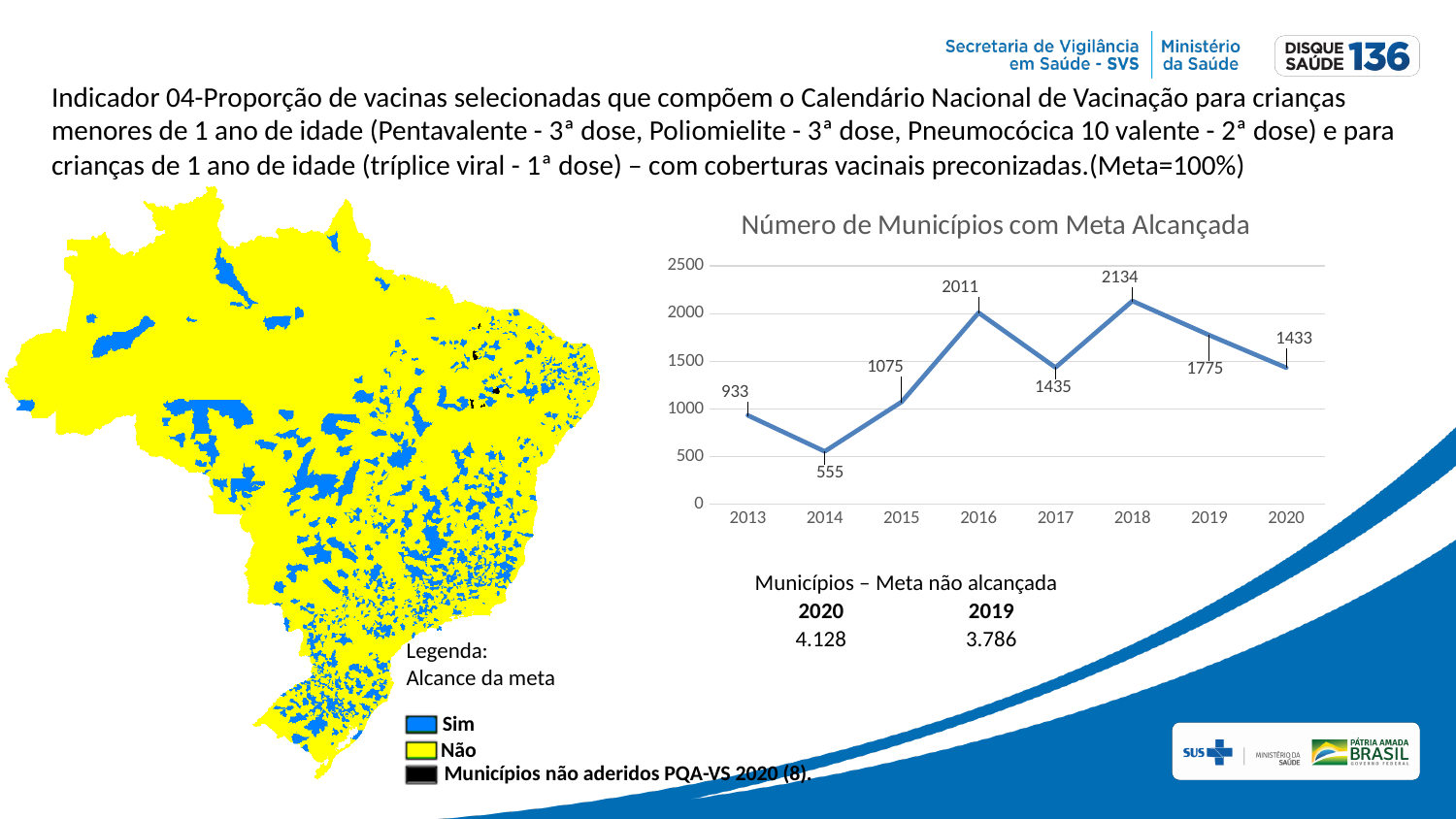
In the chart "Número de Municípios com Meta Alcançada", what is the difference between the values for 2016 and 2017? 576 In the chart "Número de Municípios com Meta Alcançada", does the value rise or fall from 2019 to 2020? fall What type of chart is "Número de Municípios com Meta Alcançada"? line chart In the chart "Número de Municípios com Meta Alcançada", which year has the highest value? 2018 In the chart "Número de Municípios com Meta Alcançada", what is the value for 2014? 555 In the chart "Número de Municípios com Meta Alcançada", what is the value for 2016? 2011 How many years are plotted in the chart "Número de Municípios com Meta Alcançada"? 8 In the chart "Número de Municípios com Meta Alcançada", which is larger, the value for 2013 or the value for 2015? 2015 In the chart "Número de Municípios com Meta Alcançada", what is the value for 2020? 1433 In the chart "Número de Municípios com Meta Alcançada", which year has the lowest value? 2014 In the chart "Número de Municípios com Meta Alcançada", what is the difference between the values for 2018 and 2019? 359 In the chart "Número de Municípios com Meta Alcançada", is the value for 2019 greater or less than 1500? greater